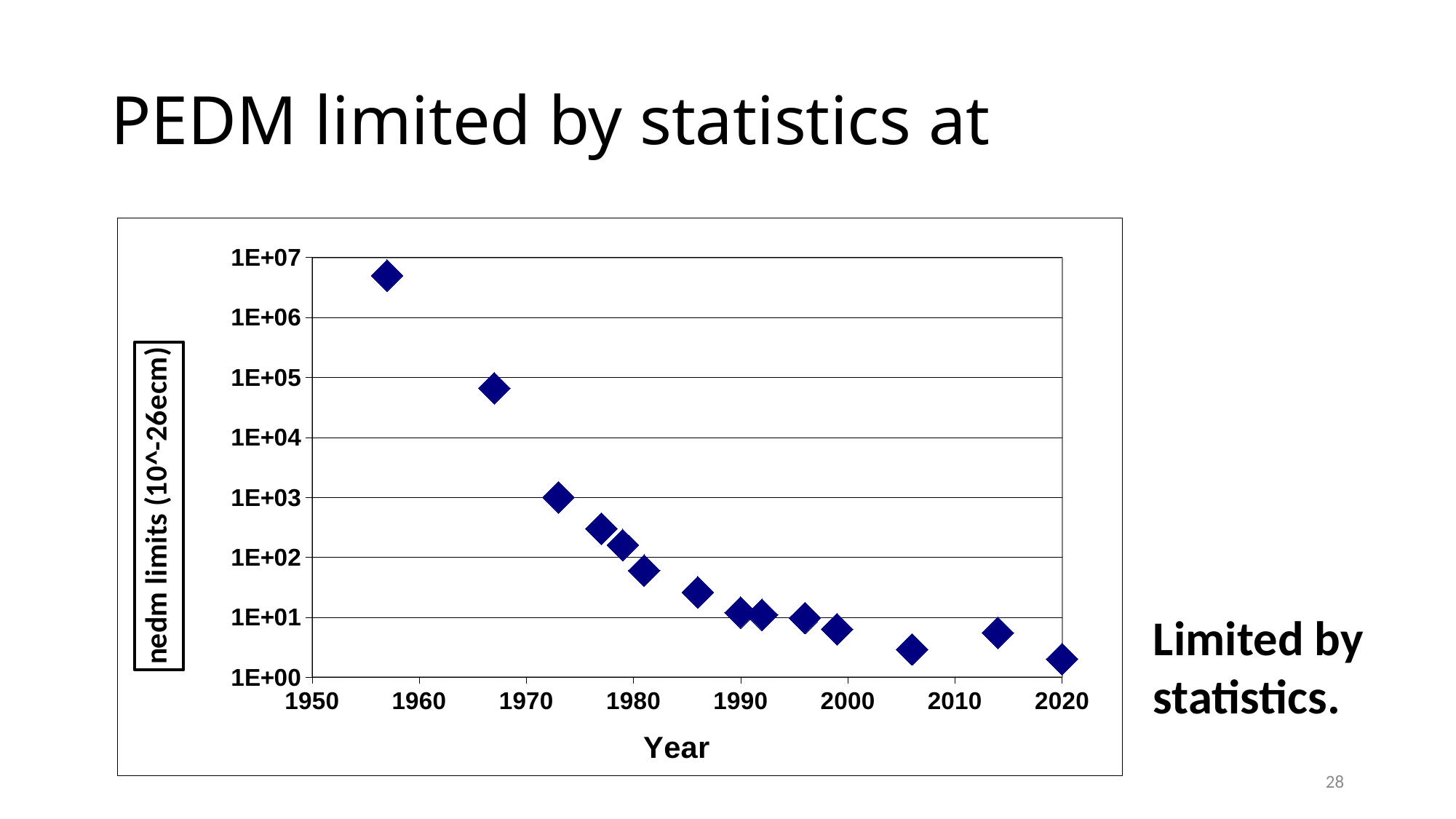
Is the value for the point near 1967 greater or less than 1E+04? greater Which point has the larger value, the one near 2006 or the one near 2014? the one near 2014 Is the value for the point near 1981 greater or less than 1E+02? less Is the value for the point near 1986 greater or less than 1E+01? greater What is the label of the x axis? Year Which year's point has the lowest nedm limit value? the latest point, near 2020 Do the nedm limit values rise or fall as the year increases along the x axis? fall Which year's point has the highest nedm limit value? the earliest point, near 1957 What is the label of the y axis? nedm limits (10^-26ecm) What kind of chart is shown on the slide? scatter chart